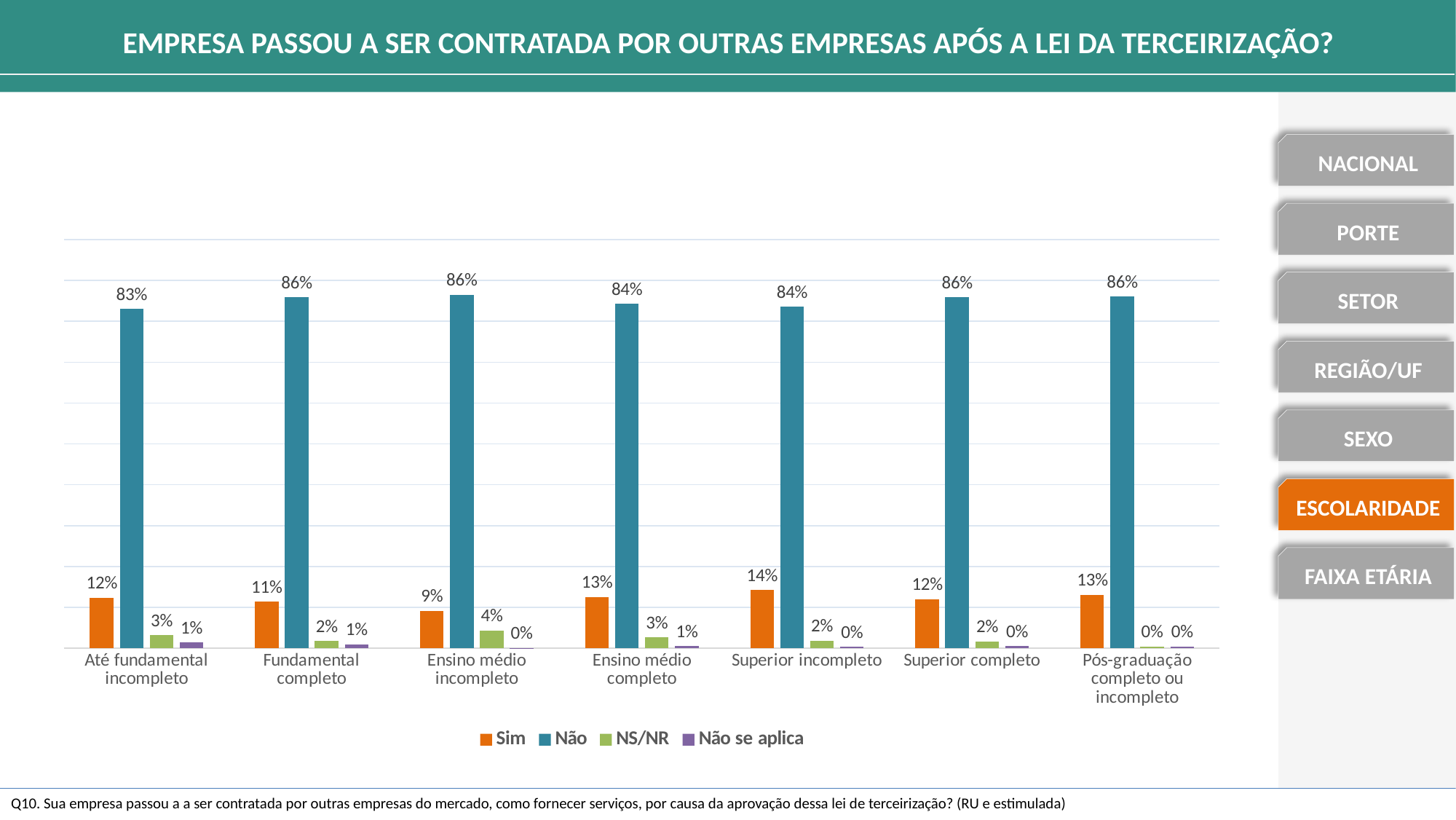
Which category has the lowest value for "Não"? Até fundamental incompleto How many education-level categories are shown on the x axis? 7 What is the value for "Sim" in the "Ensino médio completo" category? 13% How many series does the legend list? 4 What is the difference between the "Não" value for "Fundamental completo" and the "Não" value for "Até fundamental incompleto"? 3% Which category has the lowest value for "Sim"? Ensino médio incompleto What is the value for "NS/NR" in the "Ensino médio incompleto" category? 4% What is the value for "Não" in the "Até fundamental incompleto" category? 83% Which is larger: the "Sim" value for "Superior incompleto" or the "Sim" value for "Superior completo"? Superior incompleto Which series is shown in orange in the legend? Sim What kind of chart is shown on the slide? Bar chart Which category has the highest value for "Sim"? Superior incompleto